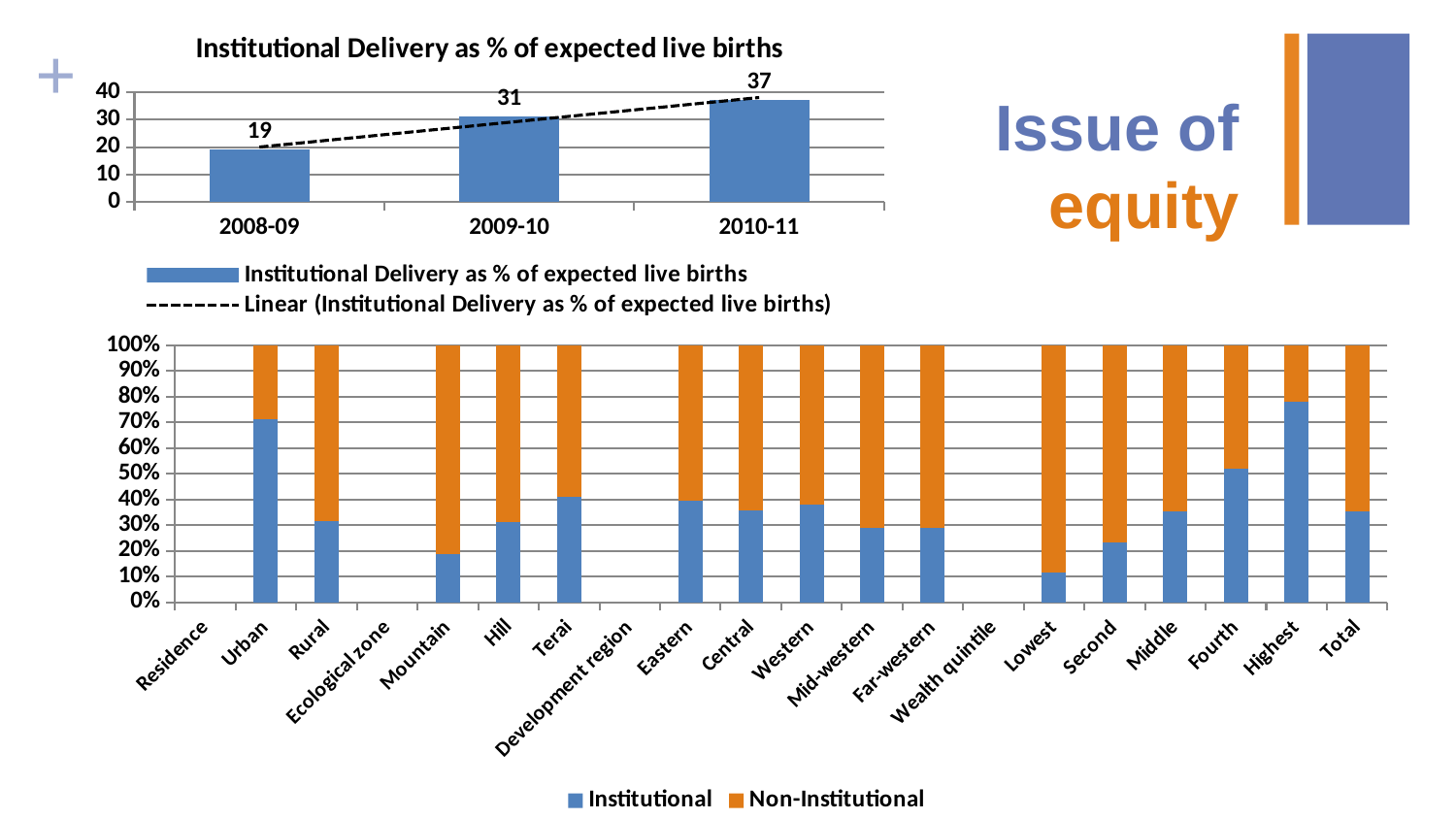
In the bottom chart, which has the larger Institutional share, Urban or Rural? Urban In the top chart, how many years are plotted? 3 In the top chart, do the values rise or fall from 2008-09 to 2010-11? rise What kind of chart is the bottom chart? stacked bar chart In the top chart, which year has the highest institutional delivery percentage? 2010-11 In the top chart, what is the value for 2010-11? 37 In the bottom chart, is the Institutional value for Urban greater or less than 60%? greater In the bottom chart, is the Institutional value for Lowest greater or less than 20%? less In the bottom chart, how many series does the legend list? 2 In the top chart, what is the difference between the 2010-11 and 2008-09 values? 18 In the top chart, what is the value for 2008-09? 19 In the bottom chart, which category has the highest Institutional share? Highest